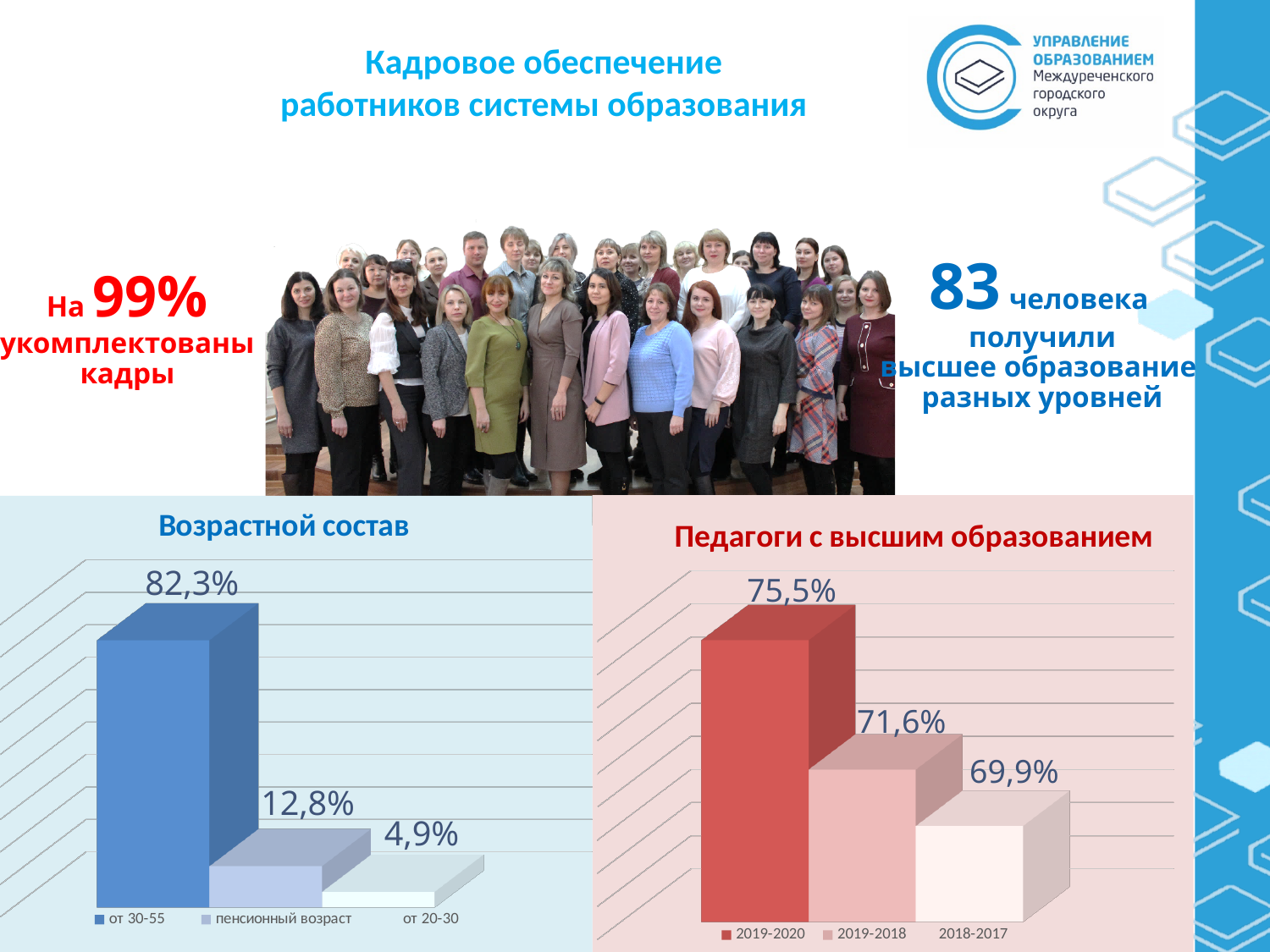
In the chart 'Педагоги с высшим образованием', what is the value for 2018-2017? 69,9% In the chart 'Возрастной состав', what is the value for 'от 30-55'? 82,3% In the chart 'Возрастной состав', what is the value for 'от 20-30'? 4,9% In the chart 'Возрастной состав', how many entries does the legend list? 3 In the chart 'Педагоги с высшим образованием', what is the value for 2019-2020? 75,5% In the chart 'Возрастной состав', which category has the lowest value? от 20-30 In the chart 'Возрастной состав', what is the value for 'пенсионный возраст'? 12,8% In the chart 'Педагоги с высшим образованием', which period has the highest value? 2019-2020 What kind of chart is 'Педагоги с высшим образованием'? bar chart In the chart 'Педагоги с высшим образованием', what is the difference between the values for 2019-2020 and 2019-2018? 3,9% In the chart 'Возрастной состав', what is the difference between the values for 'от 30-55' and 'пенсионный возраст'? 69,5% In the chart 'Педагоги с высшим образованием', which is larger: the value for 2019-2018 or for 2018-2017? 2019-2018